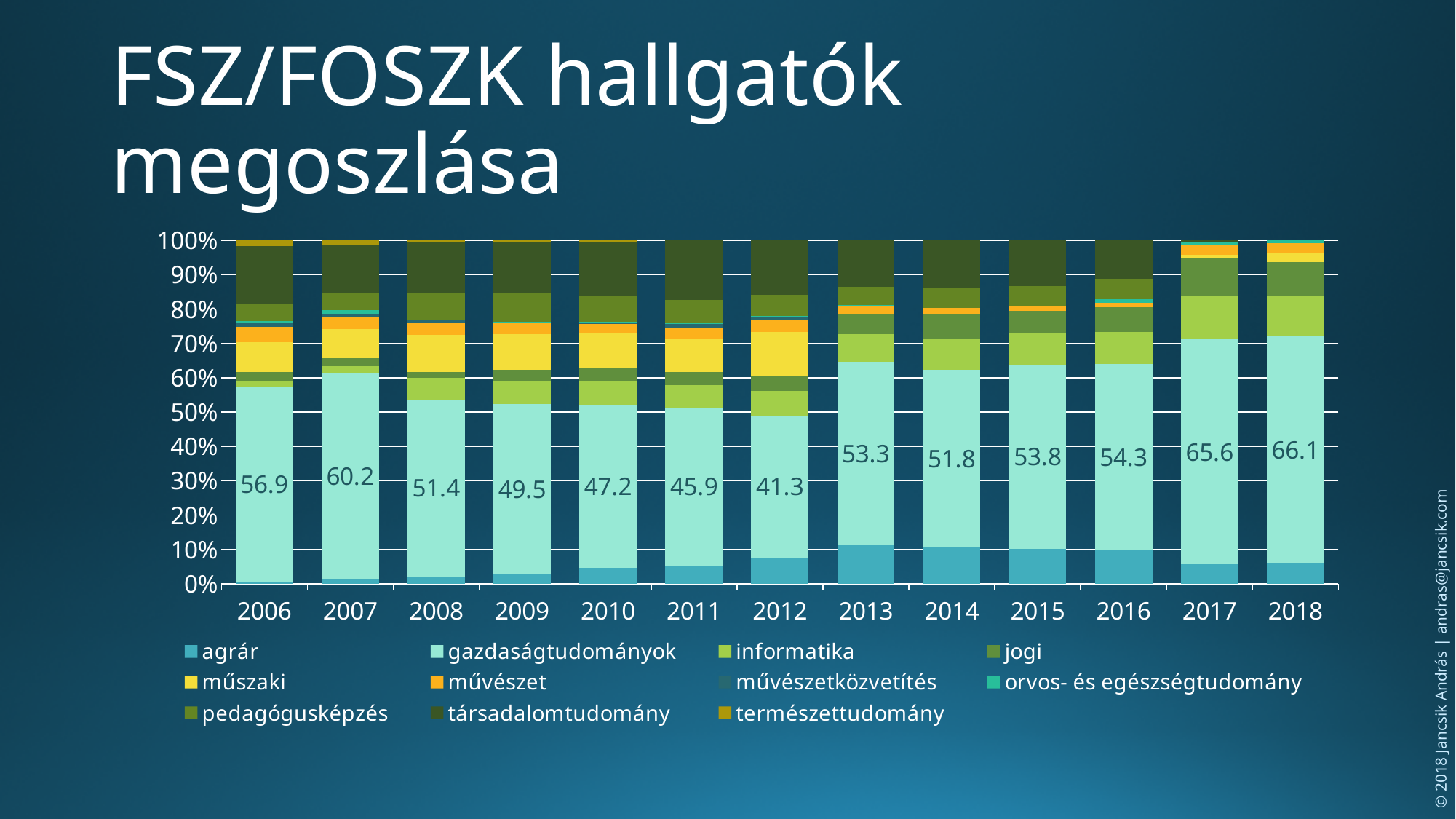
What is the data label for gazdaságtudományok in 2018? 66.1 What is the difference between the gazdaságtudományok labels for 2018 and 2012? 24.8 What is the data label for gazdaságtudományok in 2012? 41.3 In which year is the labelled gazdaságtudományok share the lowest? 2012 In which year is the labelled gazdaságtudományok share the highest? 2018 What is the data label for gazdaságtudományok in 2007? 60.2 What kind of chart is shown on the slide? Stacked bar chart How many series does the legend list? 11 Is the value for agrár in 2006 greater or less than 10%? less Do the gazdaságtudományok labels rise or fall from 2007 to 2012? fall Which year has the larger gazdaságtudományok label, 2013 or 2014? 2013 How many years are shown on the x axis? 13